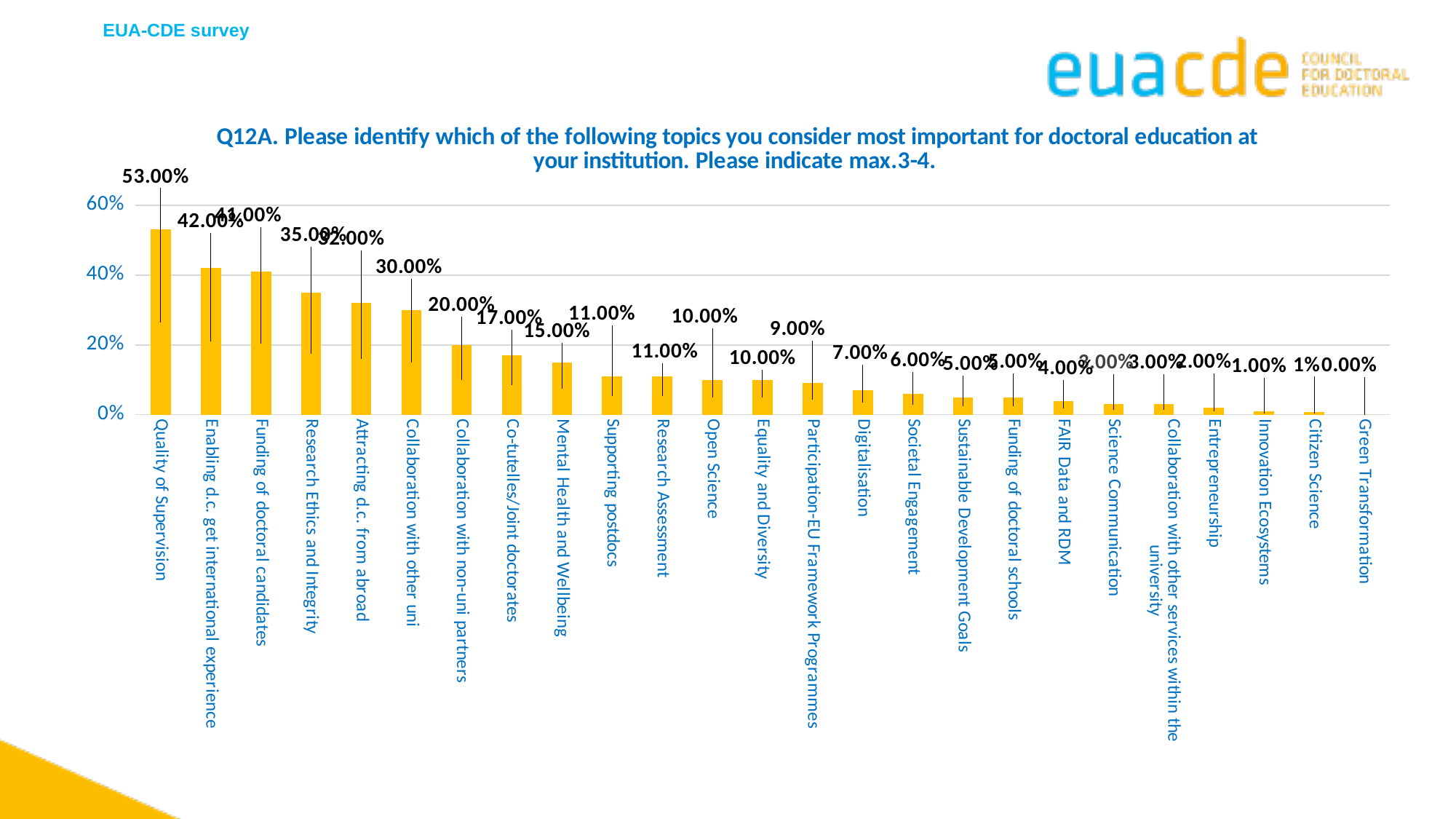
What is the difference between the values for Quality of Supervision and Collaboration with other uni? 23.00% Which topic has the highest value? Quality of Supervision What is the value for Digitalisation? 7.00% What is the value for Collaboration with other uni? 30.00% Which topic has the lowest value? Green Transformation What is the value for Quality of Supervision? 53.00% Is the value for Collaboration with non-uni partners greater or less than 40%? less What is the value for Mental Health and Wellbeing? 15.00% Do the values rise or fall from left to right along the x axis? fall How many topics are shown on the x axis? 25 Which is larger, the value for Research Ethics and Integrity or the value for Collaboration with other uni? Research Ethics and Integrity What kind of chart is shown on the slide? bar chart